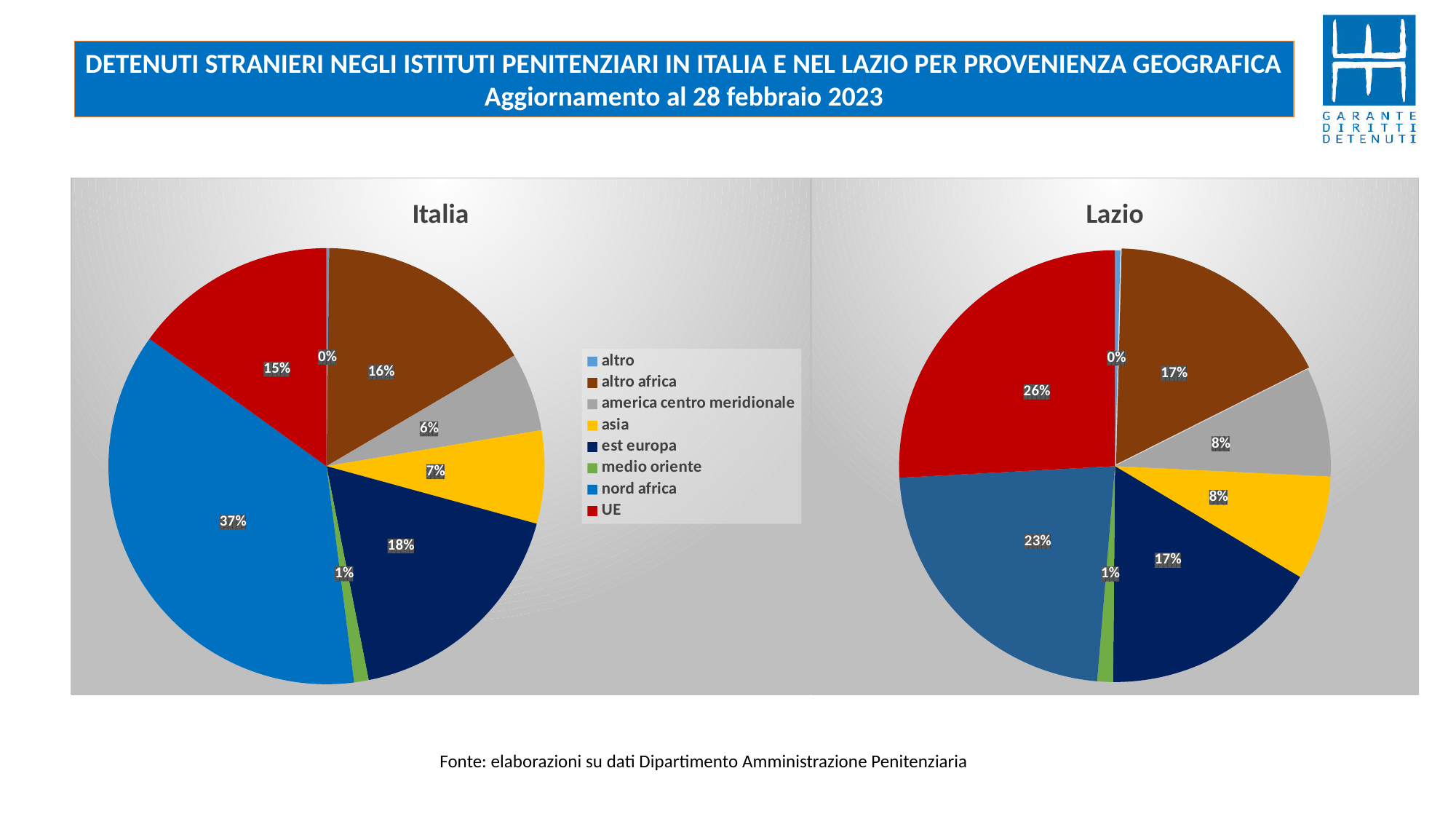
In the Lazio pie chart, which category has the largest share? UE In the Italia pie chart, what is the combined share of asia and america centro meridionale? 13% In the Lazio pie chart, what share is altro africa? 17% In the Lazio pie chart, what share is UE? 26% Which is larger: the UE share in the Italia chart or the UE share in the Lazio chart? Lazio In the Italia pie chart, what share is est europa? 18% In the Lazio pie chart, what is the difference between the nord africa share and the est europa share? 6% In the Italia pie chart, what share is nord africa? 37% In the Italia pie chart, which category has the largest share? nord africa How many categories does the legend list? 8 What kind of charts are shown on the slide? Pie charts In the Italia pie chart, which category has the smallest share? altro